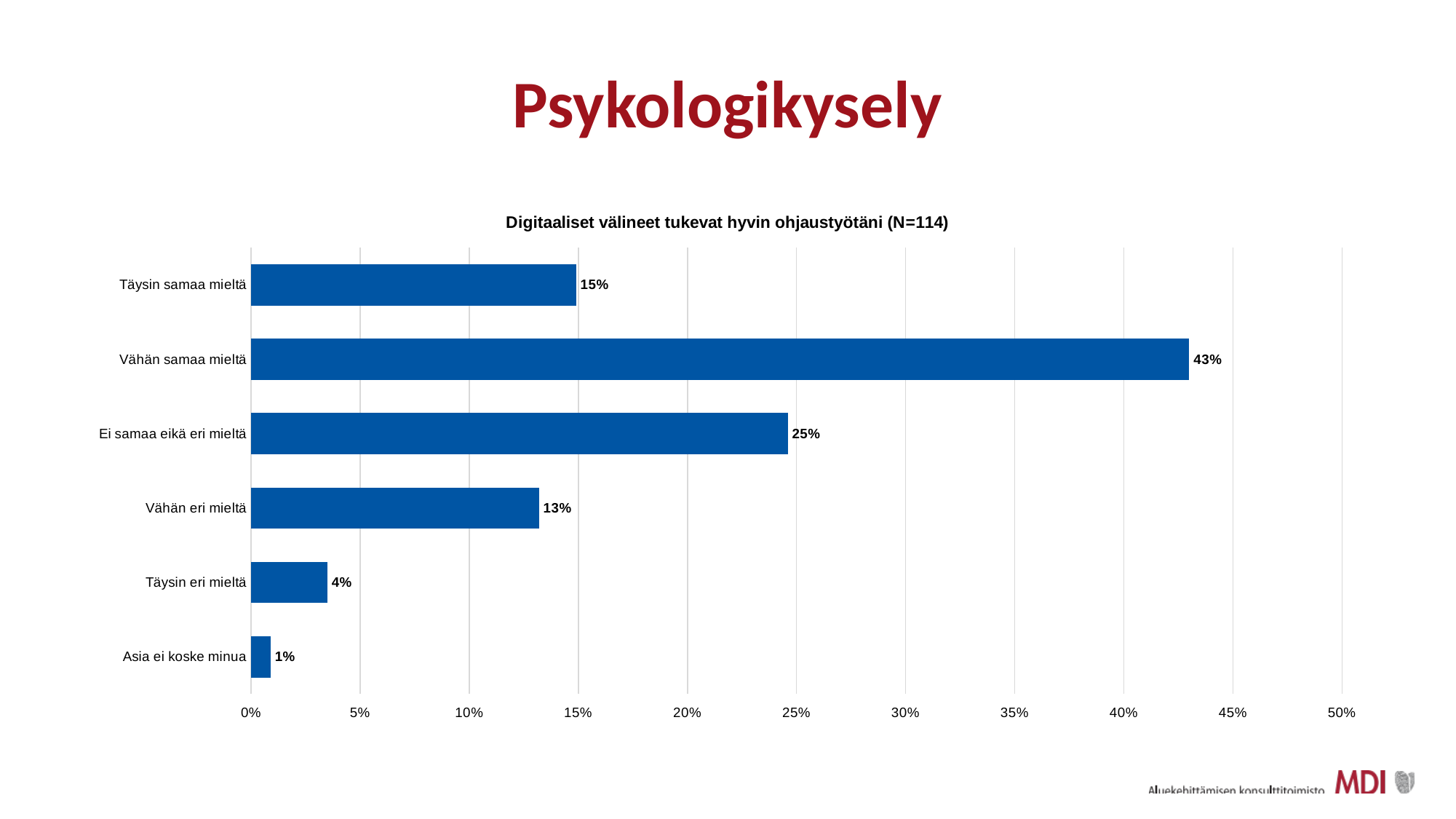
Which is larger, the value for "Täysin samaa mieltä" or the value for "Vähän eri mieltä"? Täysin samaa mieltä Is the value for "Ei samaa eikä eri mieltä" greater or less than 20%? greater What is the value for "Täysin samaa mieltä"? 15% What is the value for "Vähän samaa mieltä"? 43% What is the difference between the values for "Vähän samaa mieltä" and "Ei samaa eikä eri mieltä"? 18% What is the difference between the values for "Täysin eri mieltä" and "Asia ei koske minua"? 3% What is the value for "Asia ei koske minua"? 1% Which category has the lowest value? Asia ei koske minua Which category has the highest value? Vähän samaa mieltä What is the title of the chart? Digitaaliset välineet tukevat hyvin ohjaustyötäni (N=114) How many categories are shown in the chart? 6 What kind of chart is shown on the slide? Bar chart